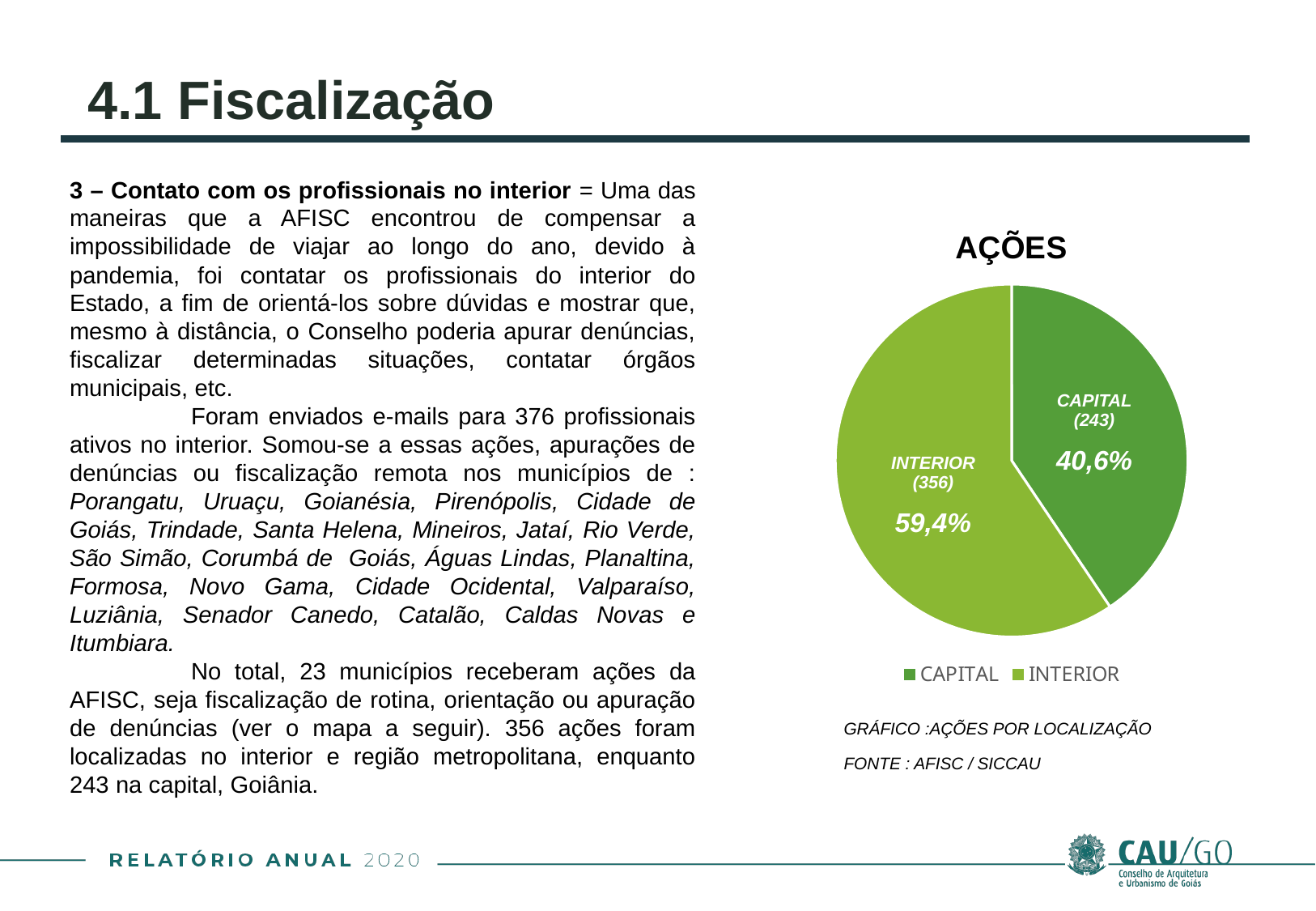
Which has more actions, CAPITAL or INTERIOR? INTERIOR Which slice is the smallest? CAPITAL How many slices does the pie chart have? 2 What is the number of actions shown for CAPITAL? 243 What is the difference in the number of actions between INTERIOR and CAPITAL? 113 What percentage share does the CAPITAL slice have? 40,6% What is the number of actions shown for INTERIOR? 356 Which slice is the largest? INTERIOR What percentage share does the INTERIOR slice have? 59,4% What kind of chart is shown on the slide? pie chart What is the title of the chart? AÇÕES How many entries does the legend list? 2